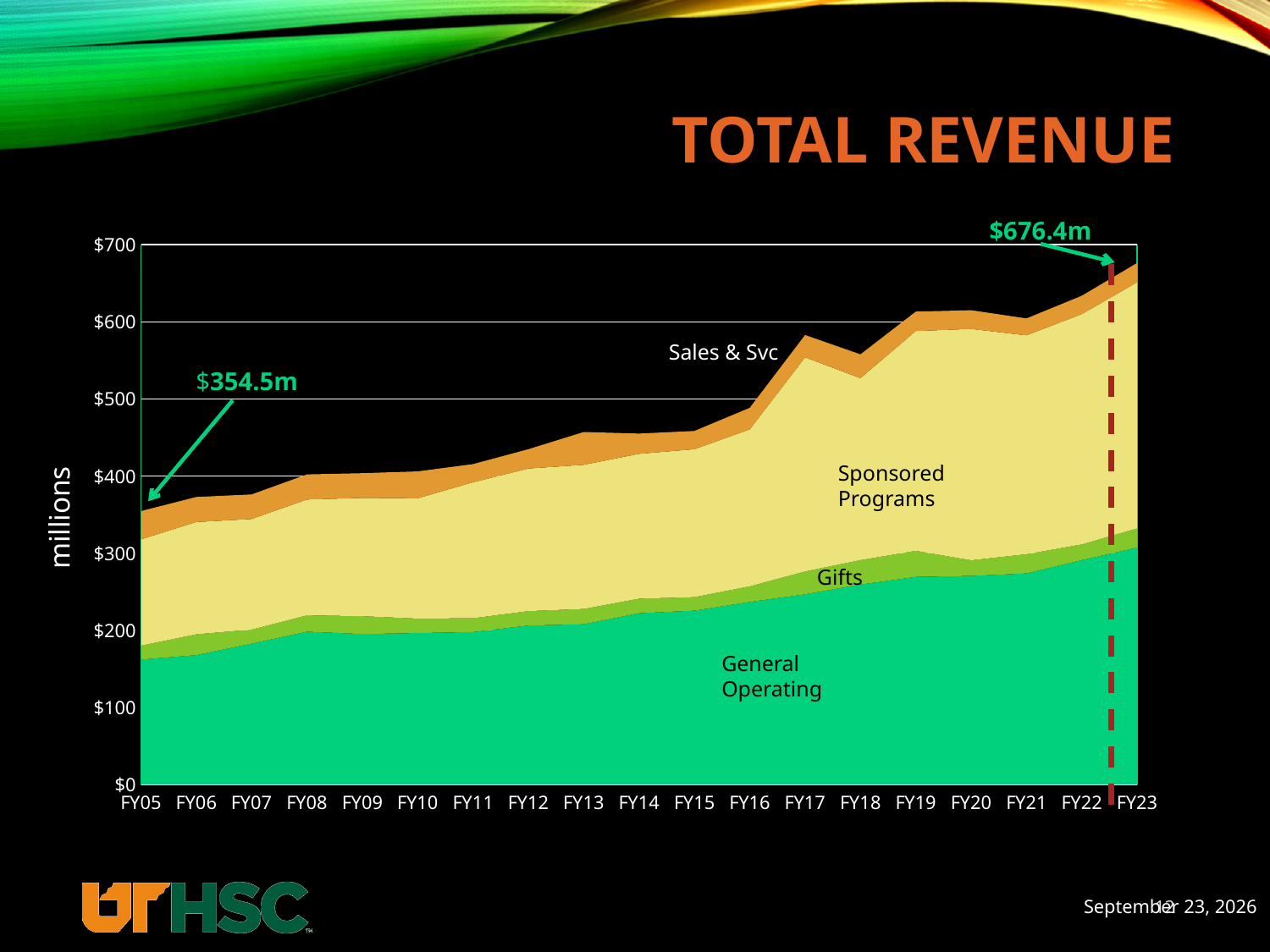
Does total revenue generally rise or fall from FY05 to FY23? rise How many revenue categories are labeled in the chart? 4 What is the total revenue labeled for FY23? $676.4m What is the difference between the labeled total revenue in FY23 and in FY05? $321.9m Which year has the higher labeled total revenue, FY05 or FY23? FY23 How many fiscal years are shown on the x axis? 19 What kind of chart is shown on the slide? area chart What is the title of the chart? TOTAL REVENUE Is the total revenue in FY18 greater or less than $600? less What is the total revenue labeled for FY05? $354.5m Is the total revenue in FY17 greater or less than $500? greater Which revenue category forms the bottom layer of the chart? General Operating